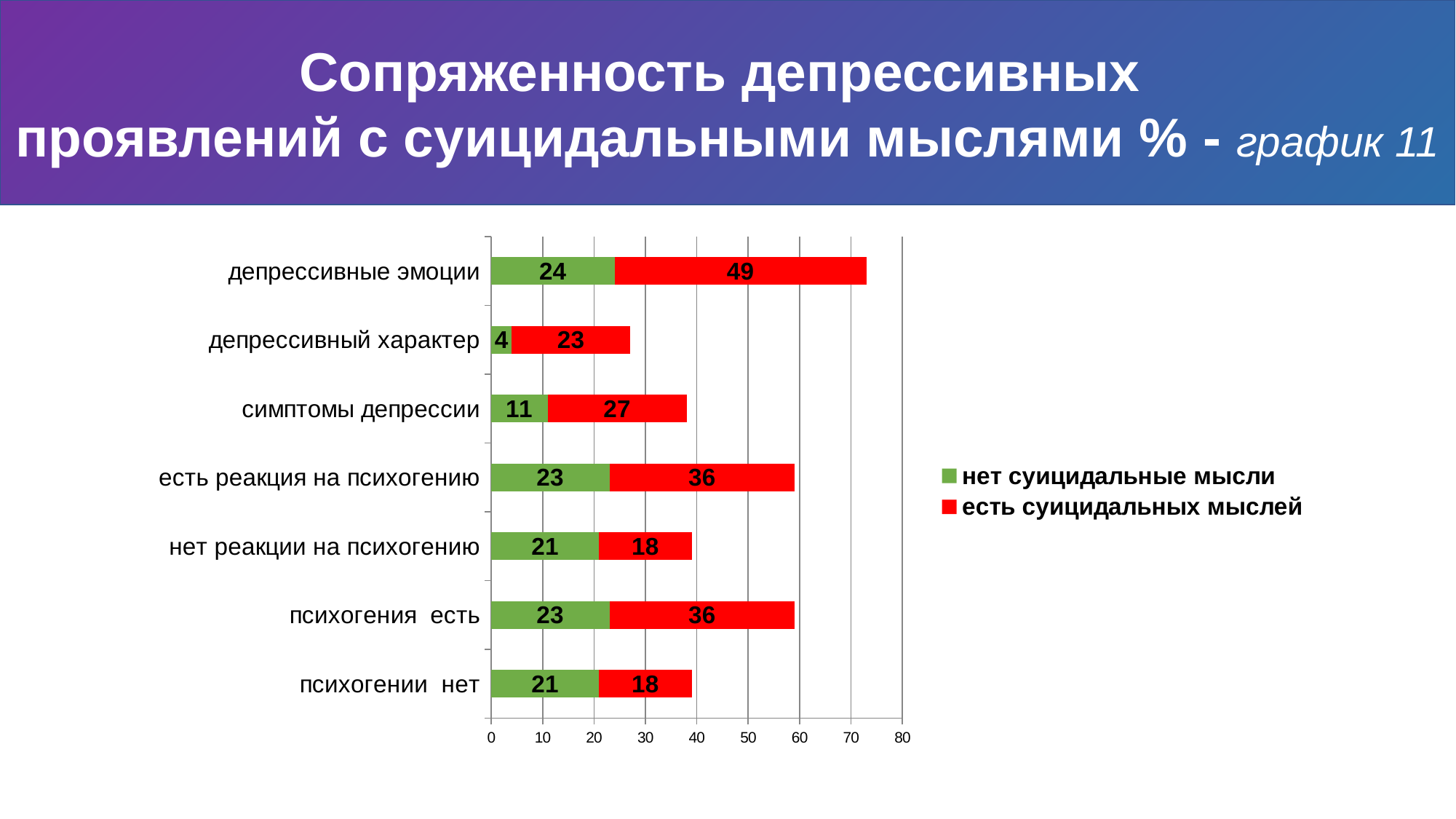
Which category has the lowest value for 'нет суицидальные мысли'? депрессивный характер How many series does the legend list? 2 What is the total of the stacked bar for 'есть реакция на психогению'? 59 What is the value of 'есть суицидальных мыслей' for 'депрессивные эмоции'? 49 What is the difference between the 'есть суицидальных мыслей' and 'нет суицидальные мысли' values for 'депрессивные эмоции'? 25 What is the total of the stacked bar for 'психогении нет'? 39 Which category has the highest value for 'есть суицидальных мыслей'? депрессивные эмоции What is the value of 'нет суицидальные мысли' for 'депрессивный характер'? 4 How many categories are shown on the chart? 7 What is the value of 'есть суицидальных мыслей' for 'симптомы депрессии'? 27 What kind of chart is shown on the slide? Stacked bar chart Which is larger for 'нет реакции на психогению': 'нет суицидальные мысли' or 'есть суицидальных мыслей'? нет суицидальные мысли